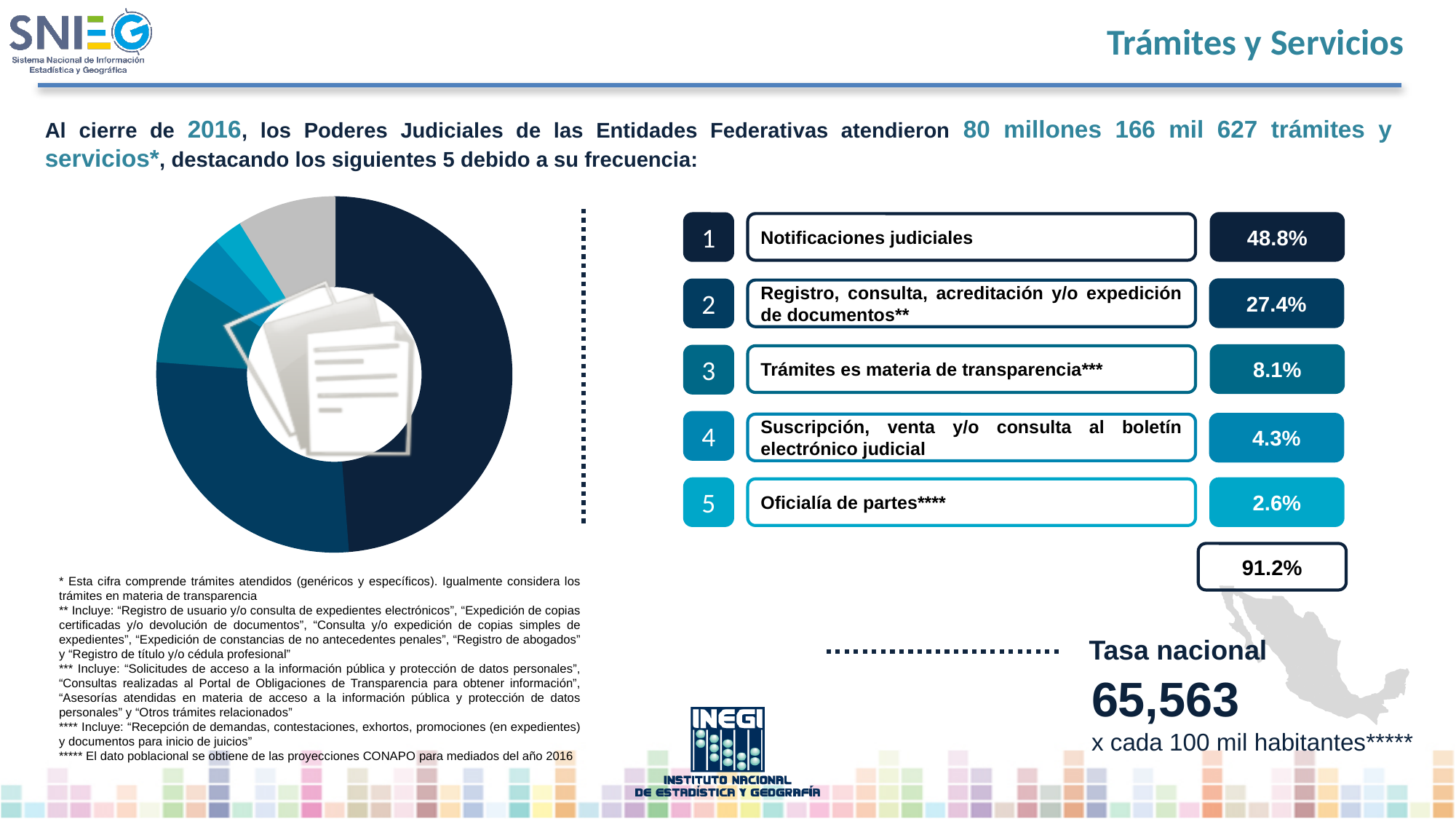
What is the combined percentage of the five listed categories? 91.2% What is the difference in percentage points between Notificaciones judiciales and Registro, consulta, acreditación y/o expedición de documentos? 21.4 percentage points What kind of chart is shown on the left of the slide? Pie chart (donut) Which of the five listed categories has the lowest percentage? Oficialía de partes What percentage corresponds to Trámites en materia de transparencia? 8.1% Which is larger: Trámites en materia de transparencia or Suscripción, venta y/o consulta al boletín electrónico judicial? Trámites en materia de transparencia How many ranked categories are listed next to the chart? 5 What is the title of the slide? Trámites y Servicios What percentage corresponds to Registro, consulta, acreditación y/o expedición de documentos? 27.4% Which of the five listed categories has the highest percentage? Notificaciones judiciales What percentage corresponds to Oficialía de partes? 2.6% What percentage corresponds to Notificaciones judiciales? 48.8%